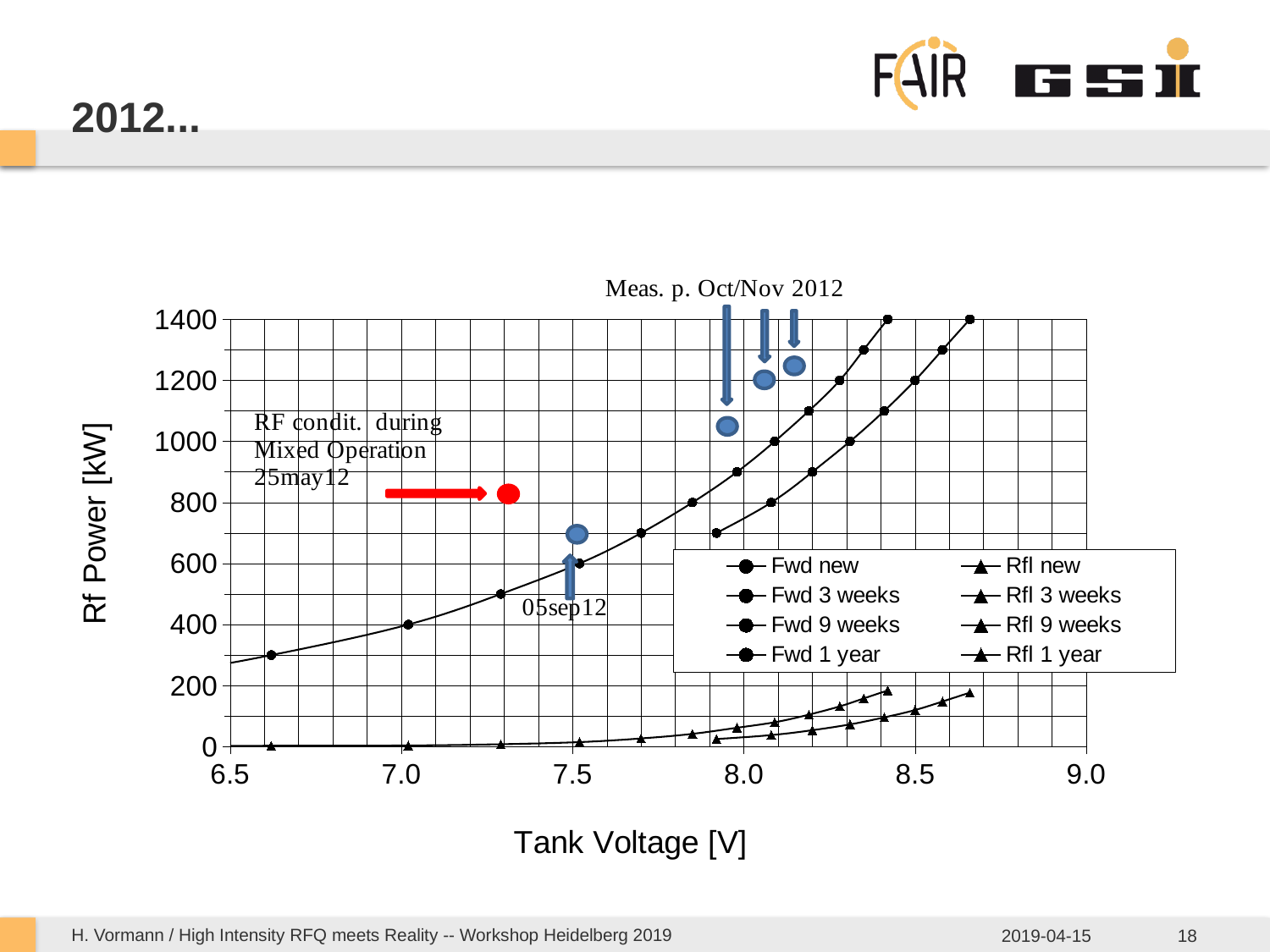
Is the forward power at a tank voltage of 7.0 V greater or less than 600? less Is the forward power at a tank voltage of 8.0 V greater or less than 600? greater What kind of chart is shown on the slide? line chart What is the title of the x axis? Tank Voltage [V] What is the title of the y axis? Rf Power [kW] Do the reflected (Rfl) power curves rise or fall as tank voltage increases? rise Is the reflected power at a tank voltage of 8.5 V greater or less than 400? less How many 'Fwd' series are listed in the legend? 4 How many 'Rfl' series are listed in the legend? 4 How many series does the chart legend list? 8 Do the forward (Fwd) power curves rise or fall as tank voltage increases? rise